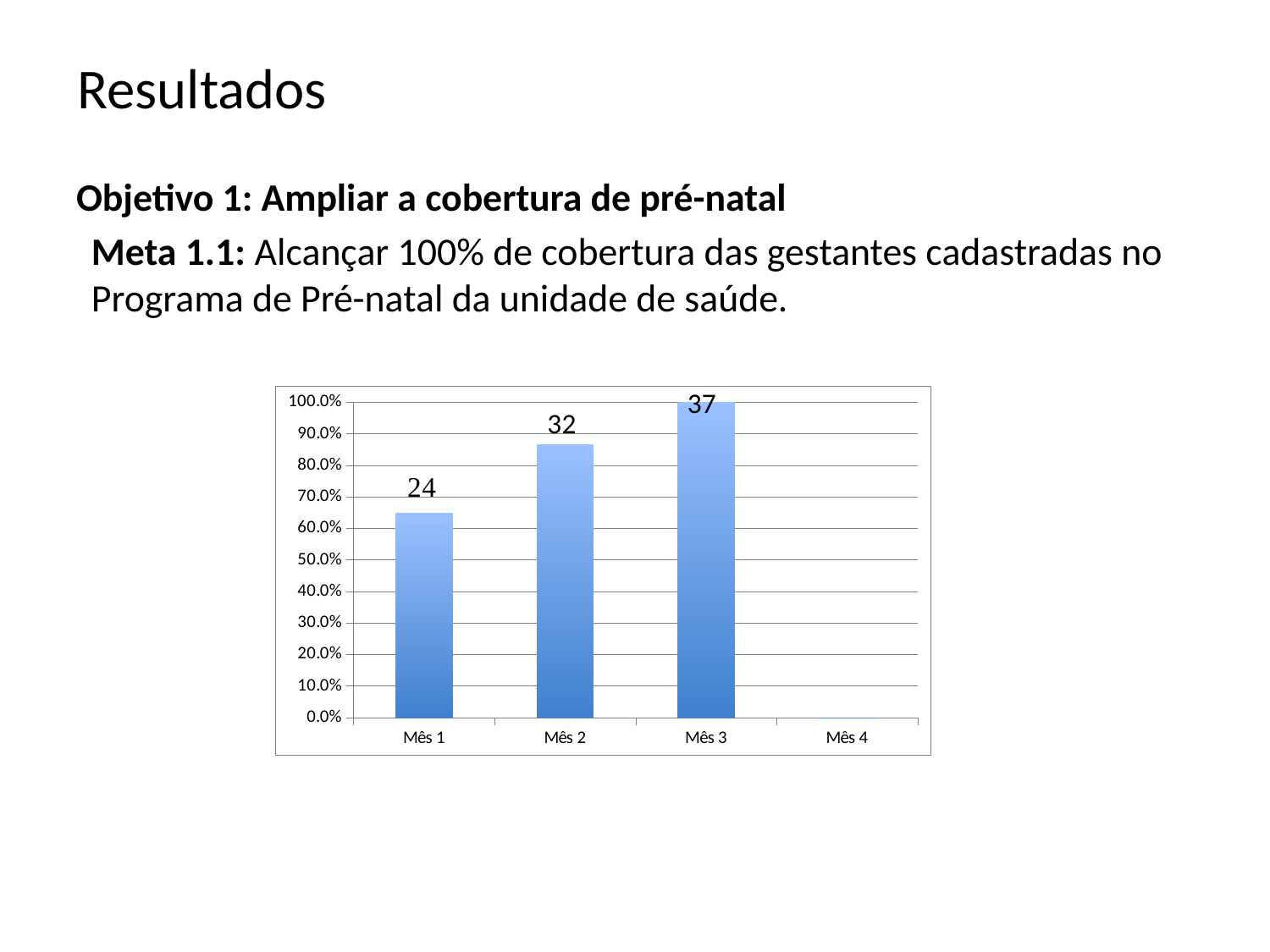
Is the value for Mês 1 greater or less than 70.0%? less What is the difference between the data labels for Mês 3 and Mês 1? 13 Which month has the lowest bar? Mês 4 Which bar is taller, Mês 1 or Mês 2? Mês 2 What kind of chart is shown on the slide? bar chart What data label is printed above the bar for Mês 2? 32 Is the value for Mês 2 greater or less than 80.0%? greater What data label is printed above the bar for Mês 1? 24 Which month has the tallest bar? Mês 3 What percentage does the bar for Mês 3 reach on the y axis? 100.0% How many categories are shown on the x axis of the chart? 4 What data label is printed above the bar for Mês 3? 37